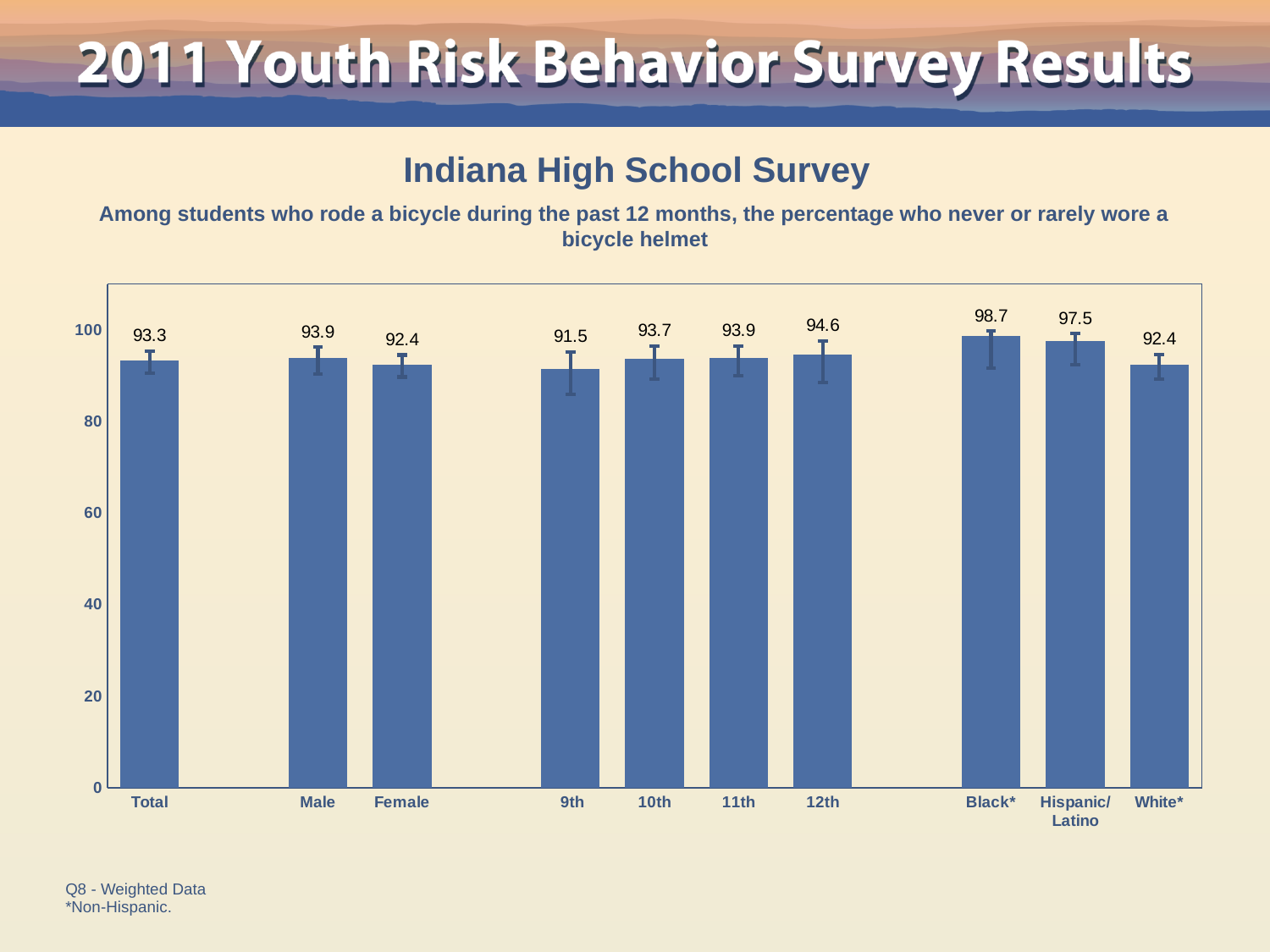
Do the values rise or fall from 9th grade to 12th grade? rise What is the difference between the values for Male and Female? 1.5 What is the value for Total? 93.3 What is the value for Black*? 98.7 Which is larger, the value for 12th grade or the value for 10th grade? 12th What kind of chart is shown on the slide? bar chart How many categories are shown on the x axis? 10 Which category has the highest value? Black* Which category has the lowest value? 9th What is the difference between the values for Black* and White*? 6.3 What is the value for 9th grade? 91.5 What is the value for Hispanic/Latino? 97.5